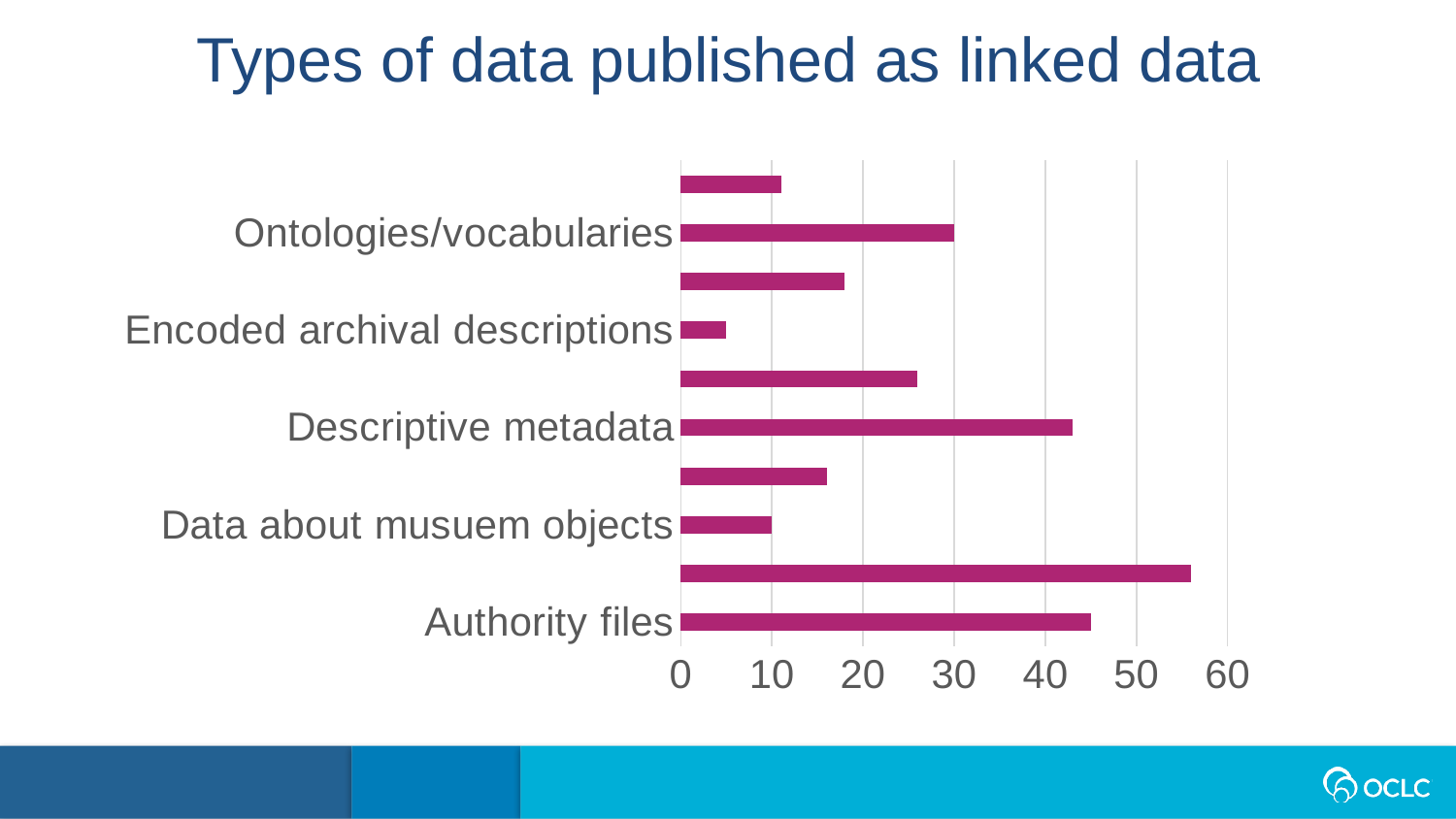
What kind of chart is shown on the slide? bar chart Is the value for Ontologies/vocabularies greater or less than 20? greater Which has the larger value, Authority files or Data about musuem objects? Authority files Is the value for Authority files greater or less than 40? greater How many bars are plotted in the chart? 10 Of the labelled categories, which has the shortest bar? Encoded archival descriptions What is the highest value shown on the horizontal axis? 60 What is the title of the chart? Types of data published as linked data Is the value for Data about musuem objects greater or less than 20? less Which has the larger value, Descriptive metadata or Encoded archival descriptions? Descriptive metadata